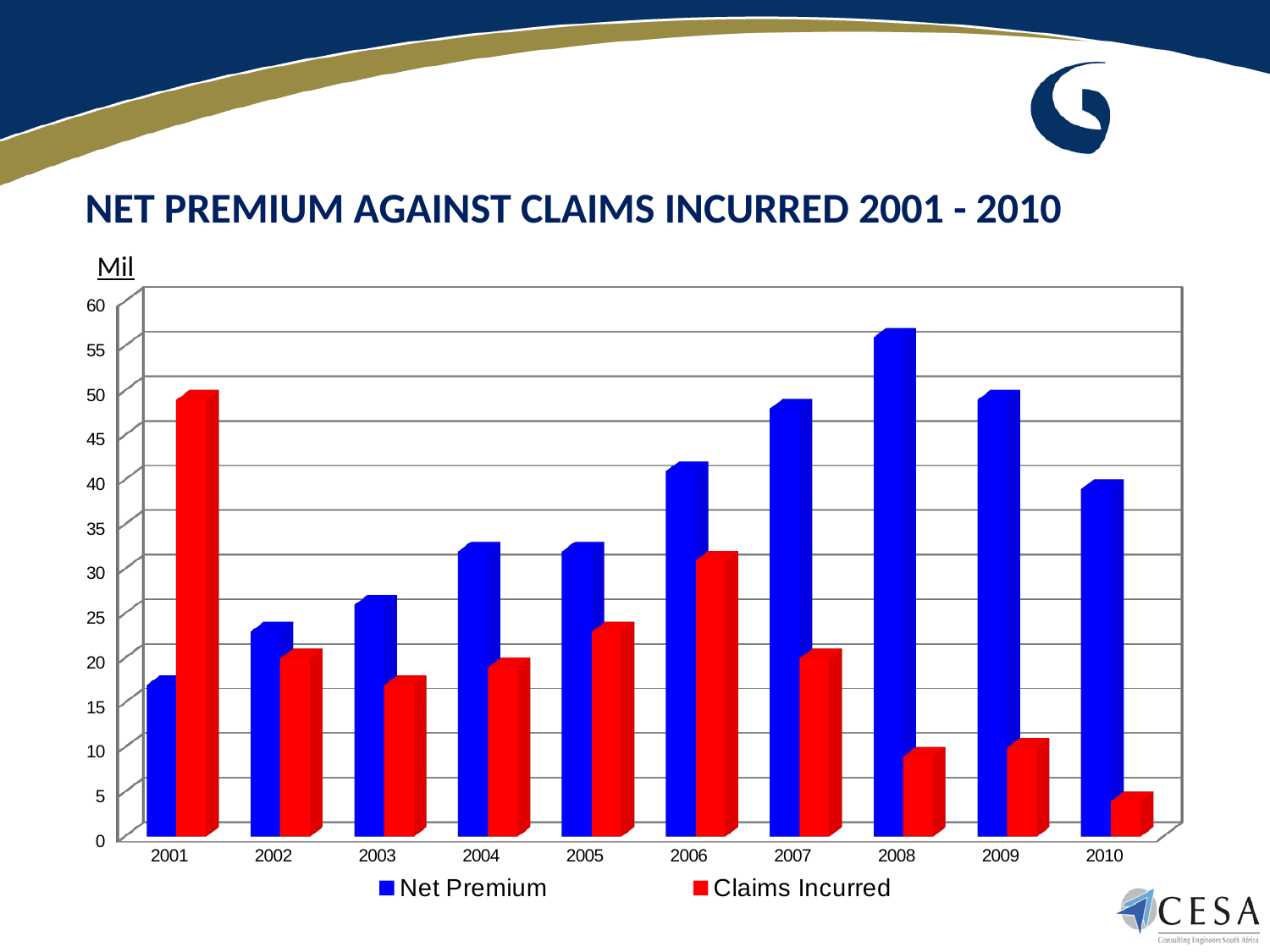
Which colour represents Claims Incurred in the legend? red How many series does the legend list? 2 Is the Claims Incurred value for 2010 greater or less than 10? less In which year is Claims Incurred highest? 2001 In 2001, which is larger: Net Premium or Claims Incurred? Claims Incurred Is the Net Premium value for 2008 greater or less than 50? greater In which year is Net Premium highest? 2008 How many years are shown on the x axis? 10 In which year is Claims Incurred lowest? 2010 Does Net Premium rise or fall from 2001 to 2008? rise What kind of chart is shown on the slide? bar chart In which year is Net Premium lowest? 2001